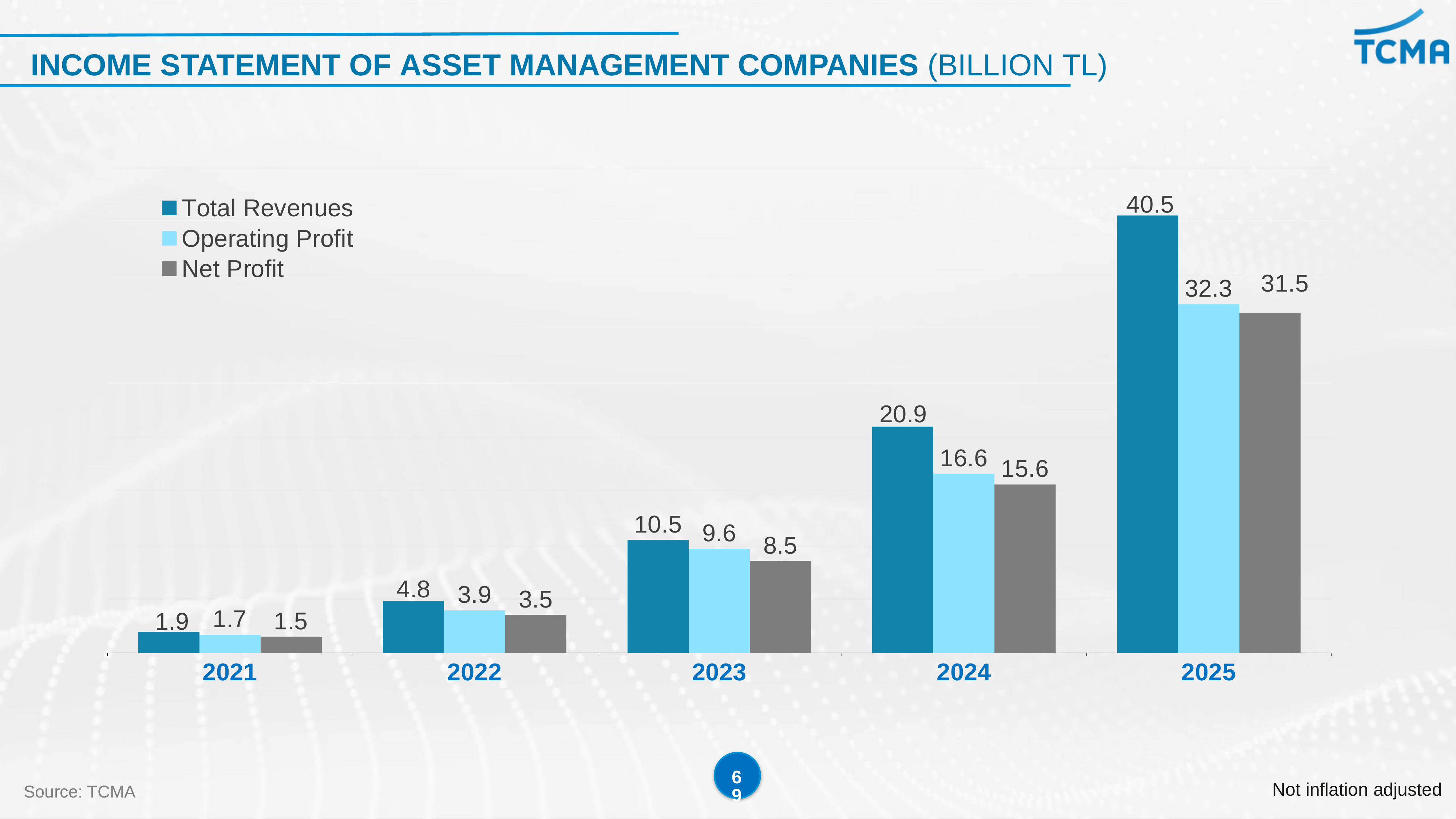
What unit is stated in the chart title? Billion TL What is the Total Revenues value for 2025? 40.5 Do Total Revenues rise or fall from 2021 to 2025? Rise What is the Operating Profit value for 2023? 9.6 In which year is Net Profit lowest? 2021 How many years are shown on the x axis? 5 In which year is Total Revenues highest? 2025 What is the difference between Total Revenues and Net Profit in 2024? 5.3 What is the Net Profit value for 2022? 3.5 Which is larger in 2025: Operating Profit or Net Profit? Operating Profit What kind of chart is shown on the slide? Bar chart How many series does the legend list? 3